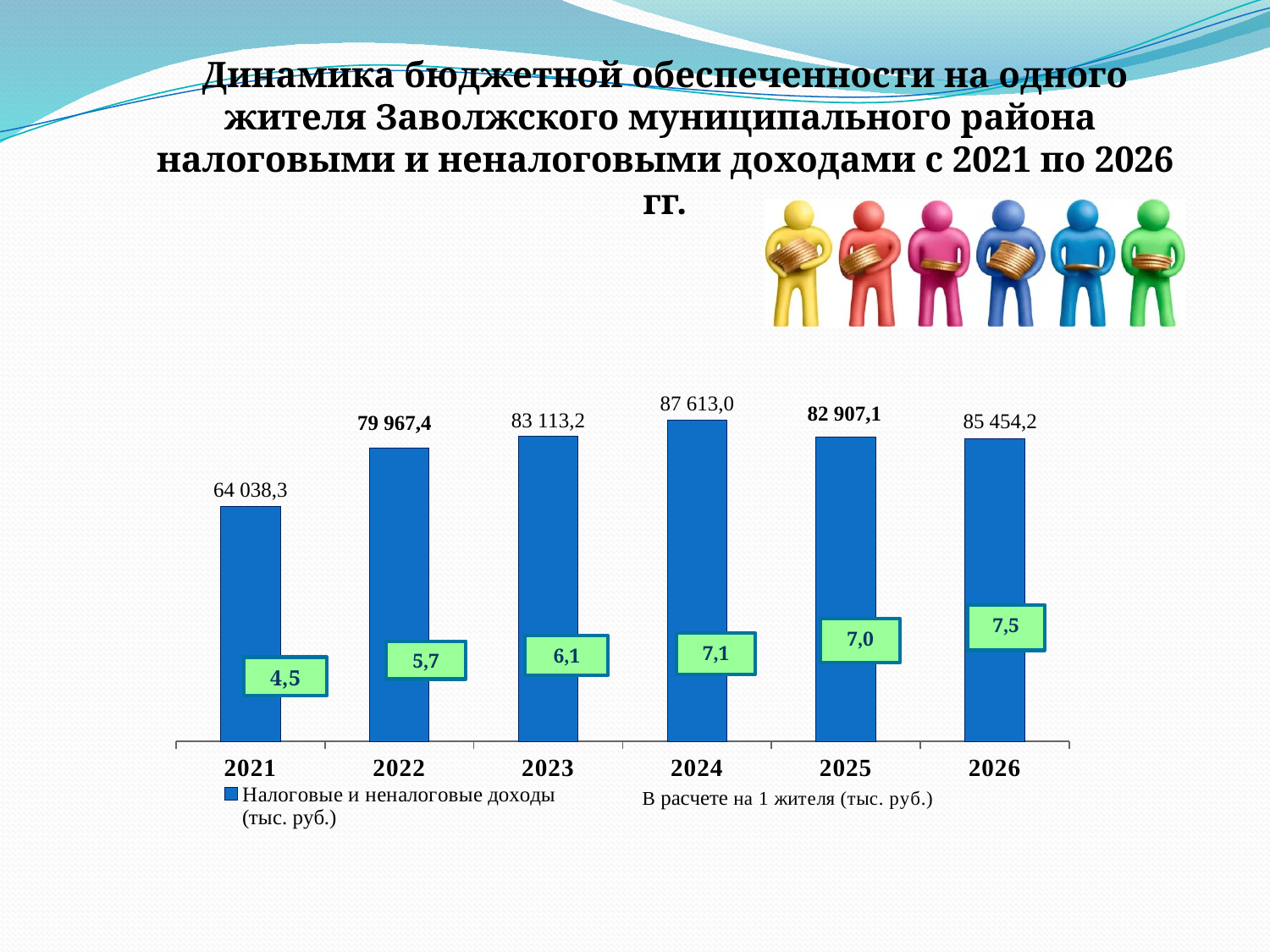
By how much do tax and non-tax revenues in 2022 exceed those in 2021? 15 929,1 What is the per-resident value (В расчете на 1 жителя, тыс. руб.) shown for 2023? 6,1 What is the value of tax and non-tax revenues (тыс. руб.) for 2021? 64 038,3 Which year has the lowest tax and non-tax revenues? 2021 Which year has the highest tax and non-tax revenues? 2024 What is the value of tax and non-tax revenues (тыс. руб.) for 2024? 87 613,0 Do tax and non-tax revenues rise or fall from 2021 to 2024? rise What is the per-resident value (В расчете на 1 жителя, тыс. руб.) shown for 2026? 7,5 How many years are shown on the x axis of the chart? 6 By how much does the per-resident value in 2026 exceed the per-resident value in 2021? 3,0 What kind of chart is shown on the slide? bar chart